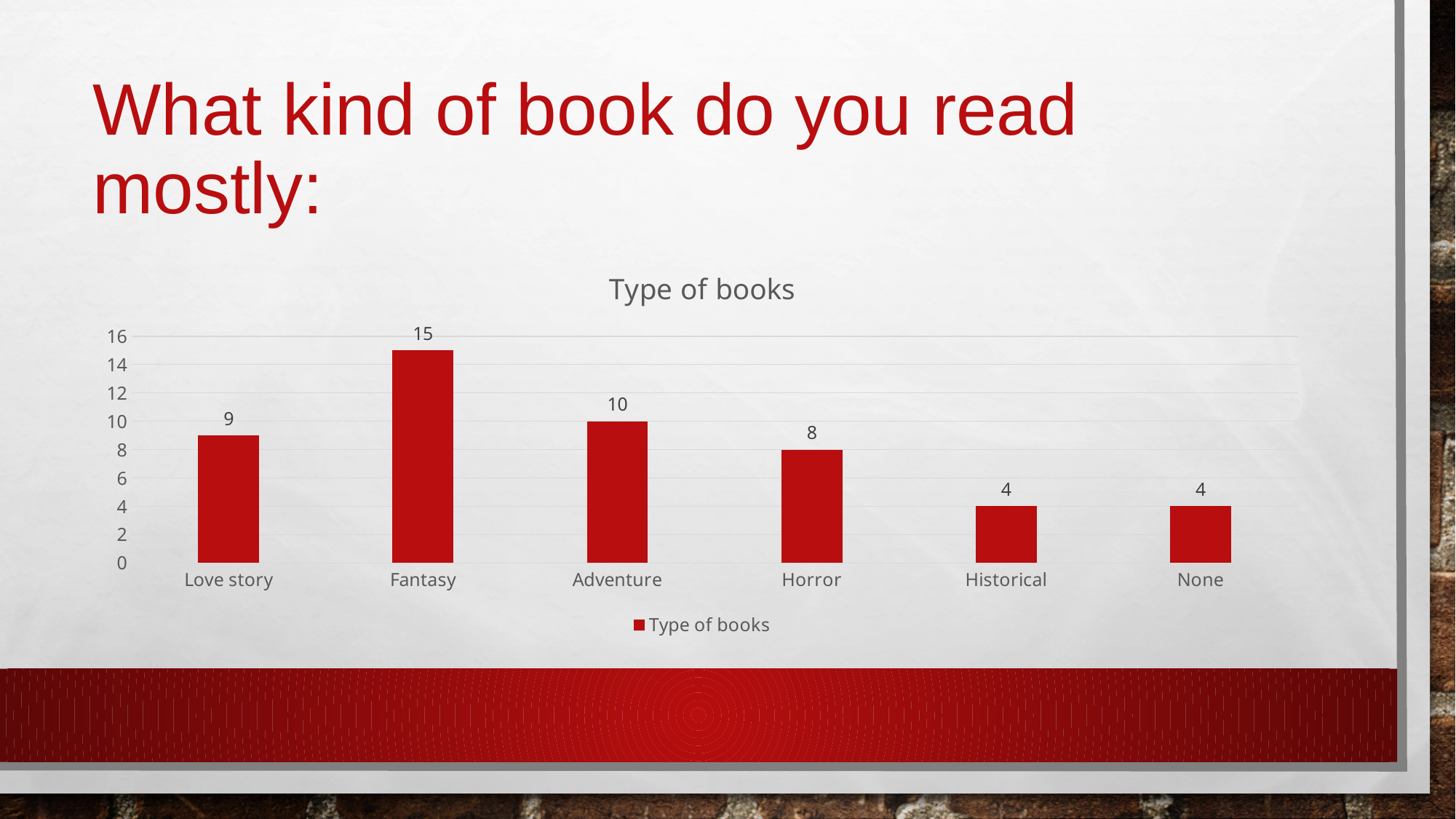
Which is larger, the value for Adventure or the value for Horror? Adventure Which categories share the lowest value? Historical and None What is the difference between the values for Love story and Historical? 5 What is the value for Love story? 9 What is the value for Horror? 8 Which category has the highest value? Fantasy What kind of chart is shown on the slide? bar chart How many categories are shown on the x axis? 6 Is the value for Fantasy greater or less than 12? greater What is the difference between the values for Fantasy and Adventure? 5 What is the title of the chart? Type of books What is the value for Fantasy? 15